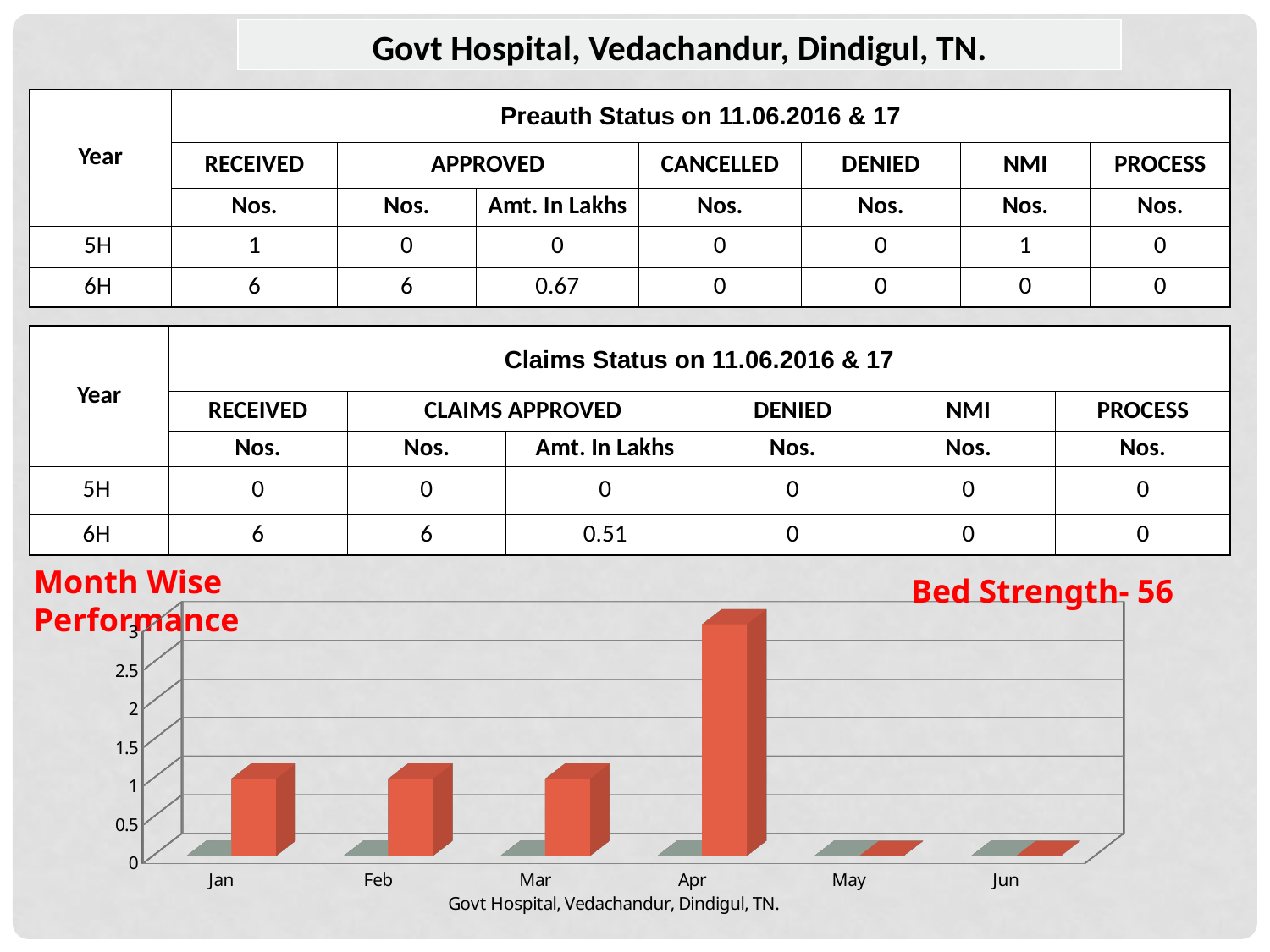
How many months are shown on the x axis of the Month Wise Performance chart? 6 Is the value for Jan in the Month Wise Performance chart greater or less than 2? less What kind of chart is shown at the bottom of the slide? bar chart What is the highest tick value shown on the y axis of the Month Wise Performance chart? 3 Is the value for Apr in the Month Wise Performance chart greater or less than 2? greater Is the value for May in the Month Wise Performance chart greater or less than 0.5? less In the Month Wise Performance chart, which is larger, the value for Feb or the value for May? Feb In the Month Wise Performance chart, which is larger, the value for Apr or the value for Mar? Apr What text appears below the x axis of the Month Wise Performance chart? Govt Hospital, Vedachandur, Dindigul, TN. Which month has the highest bar in the Month Wise Performance chart? Apr